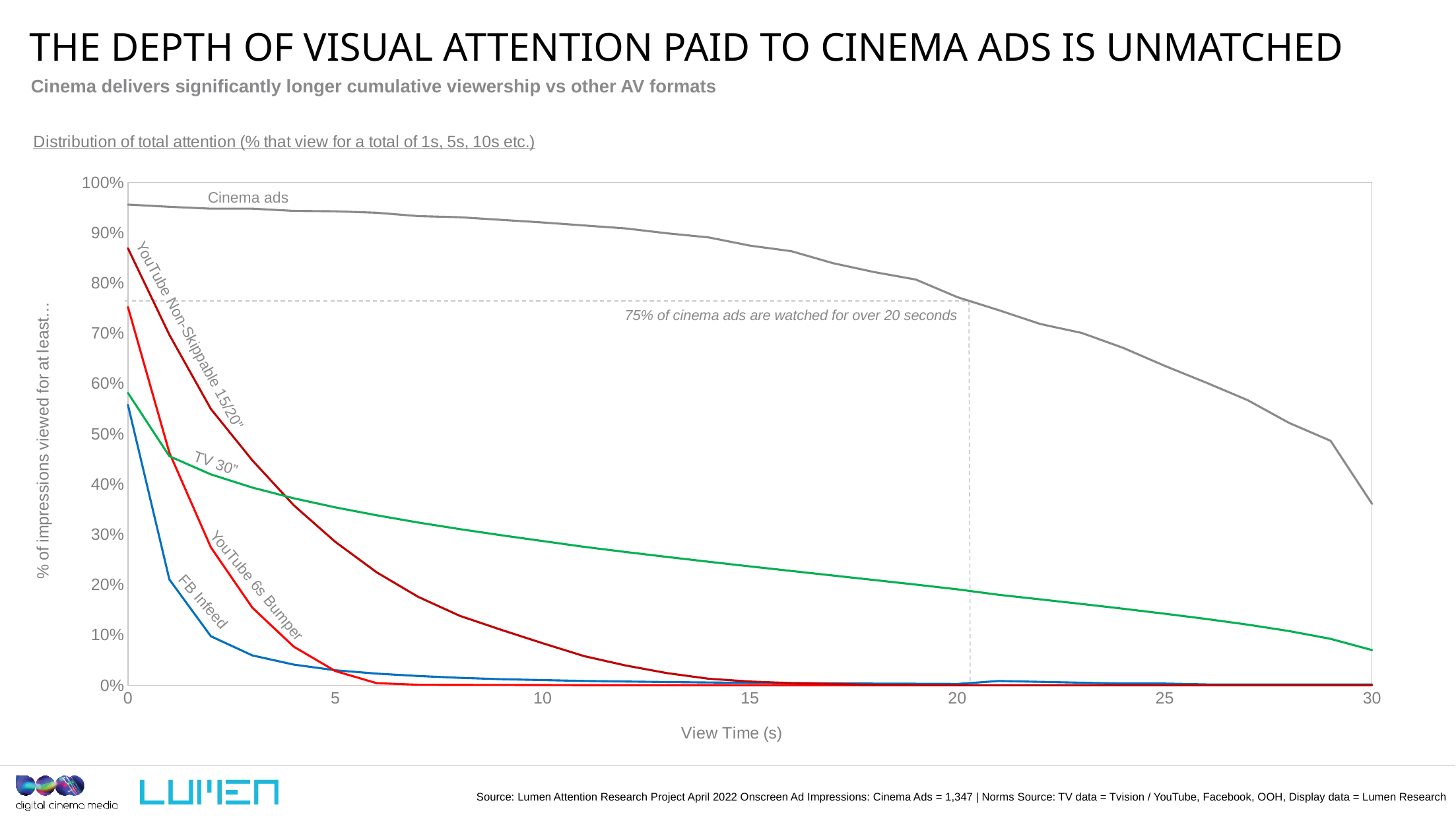
At a view time of 5 seconds, which is higher: TV 30" or YouTube 6s Bumper? TV 30" According to the annotation on the chart, what percentage of cinema ads are watched for over 20 seconds? 75% Is the value for TV 30" at a view time of 10 seconds greater or less than 20%? greater Is the value for Cinema ads at a view time of 0 seconds greater or less than 90%? greater What is the label of the x axis? View Time (s) How many lines (series) are plotted on the chart? 5 Is the value for YouTube Non-Skippable 15/20" at a view time of 0 seconds greater or less than 80%? greater Do the values for Cinema ads rise or fall as view time increases? Fall What kind of chart is shown on the slide? Line chart Which series has the highest value at a view time of 30 seconds? Cinema ads